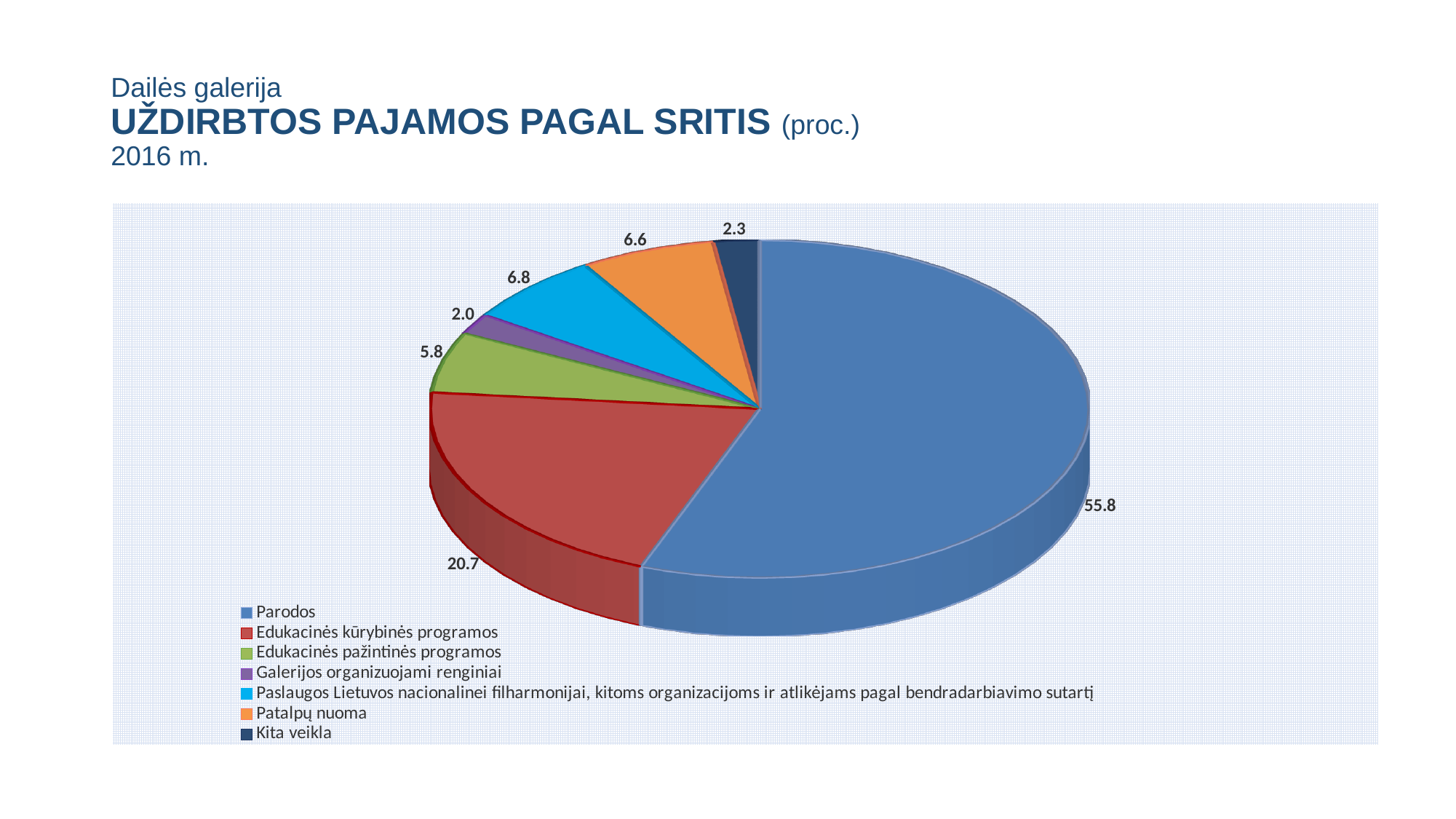
Which is larger: Edukacinės pažintinės programos or Patalpų nuoma? Patalpų nuoma Which category has the largest share of the pie? Parodos What is the value for Patalpų nuoma? 6.6 What kind of chart is shown on the slide? Pie chart What is the value for Kita veikla? 2.3 What is the value for Galerijos organizuojami renginiai? 2.0 Which colour represents Kita veikla in the legend? Dark navy blue What is the value for Edukacinės kūrybinės programos? 20.7 What is the difference between the values for Parodos and Edukacinės kūrybinės programos? 35.1 How many categories does the pie chart have? 7 Which category has the smallest share of the pie? Galerijos organizuojami renginiai What percentage of earned income comes from Parodos? 55.8